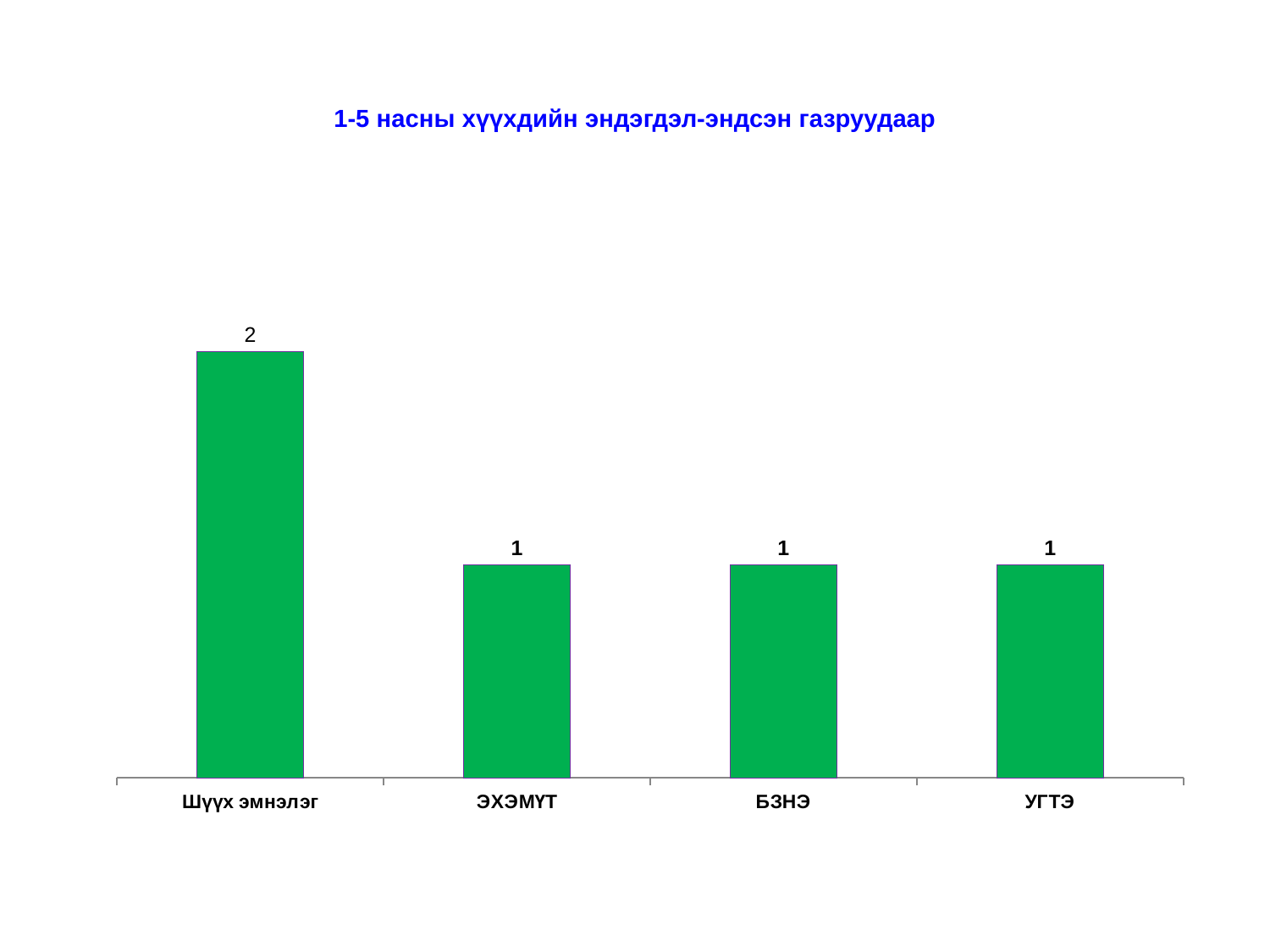
What is the difference between the values for Шүүх эмнэлэг and ЭХЭМҮТ? 1 Which category has the highest value? Шүүх эмнэлэг How many categories are shown on the x axis? 4 How many categories have a value of 1? 3 What is the value for ЭХЭМҮТ? 1 What is the value for Шүүх эмнэлэг? 2 What kind of chart is shown on the slide? Bar chart What is the title of the chart? 1-5 насны хүүхдийн эндэгдэл-эндсэн газруудаар What is the value for БЗНЭ? 1 Which is larger, the value for Шүүх эмнэлэг or the value for БЗНЭ? Шүүх эмнэлэг What is the value for УГТЭ? 1 What colour are the bars in the chart? Green